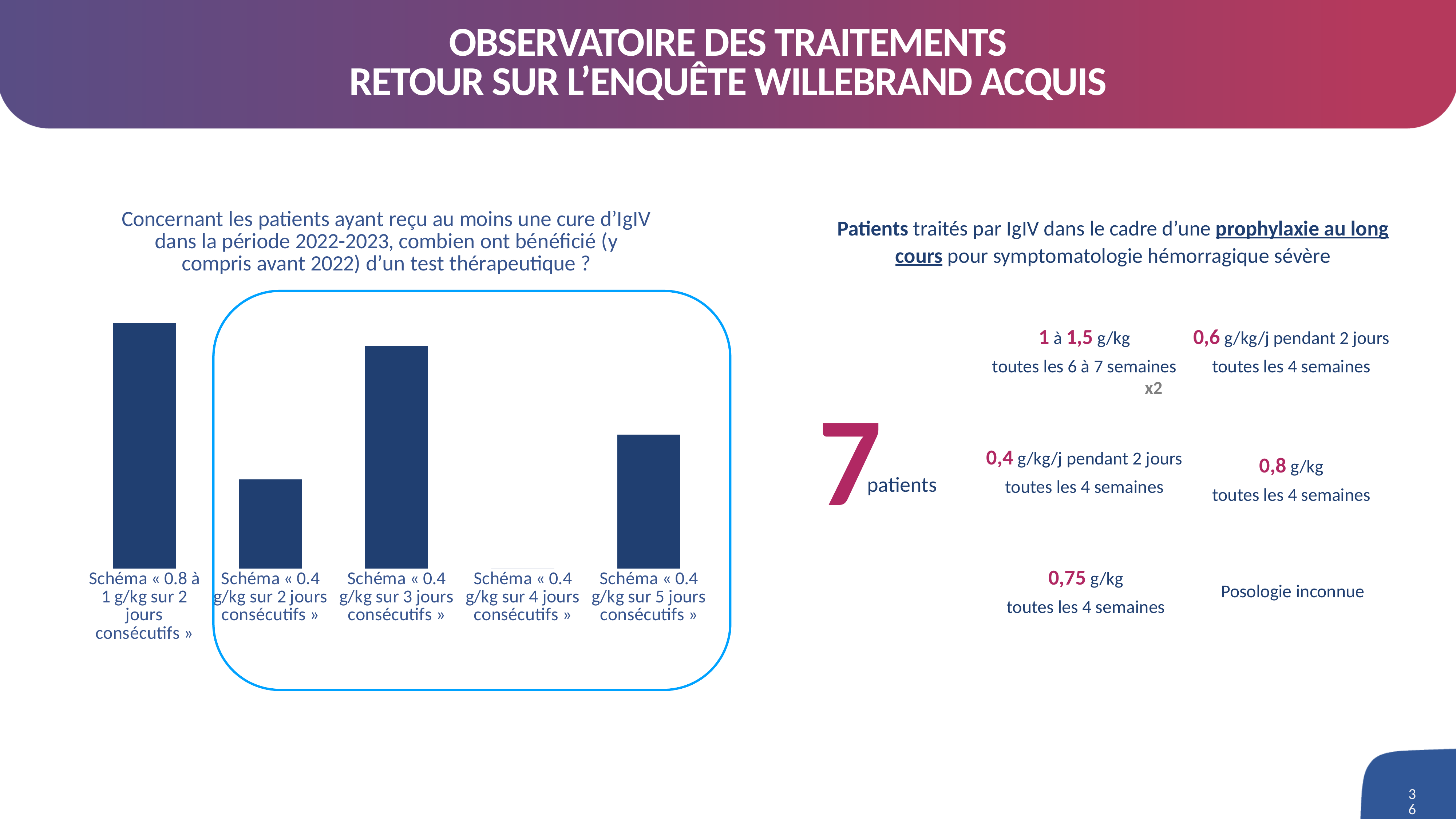
In the chart on the left, which is larger: the bar for « 0.4 g/kg sur 2 jours consécutifs » or the bar for « 0.4 g/kg sur 5 jours consécutifs »? Schéma « 0.4 g/kg sur 5 jours consécutifs » Which category has the lowest value in the chart on the left? Schéma « 0.4 g/kg sur 4 jours consécutifs » In the chart on the left, which category shows no bar at all? Schéma « 0.4 g/kg sur 4 jours consécutifs » What kind of chart is shown on the left of the slide? bar chart Which category has the tallest bar in the chart on the left? Schéma « 0.8 à 1 g/kg sur 2 jours consécutifs » In the chart on the left, which is larger: the bar for « 0.4 g/kg sur 3 jours consécutifs » or the bar for « 0.4 g/kg sur 5 jours consécutifs »? Schéma « 0.4 g/kg sur 3 jours consécutifs » What is the title of the bar chart on the left? Concernant les patients ayant reçu au moins une cure d'IgIV dans la période 2022-2023, combien ont bénéficié (y compris avant 2022) d'un test thérapeutique ? In the chart on the left, which is larger: the bar for « 0.8 à 1 g/kg sur 2 jours consécutifs » or the bar for « 0.4 g/kg sur 3 jours consécutifs »? Schéma « 0.8 à 1 g/kg sur 2 jours consécutifs » How many categories does the bar chart on the left show? 5